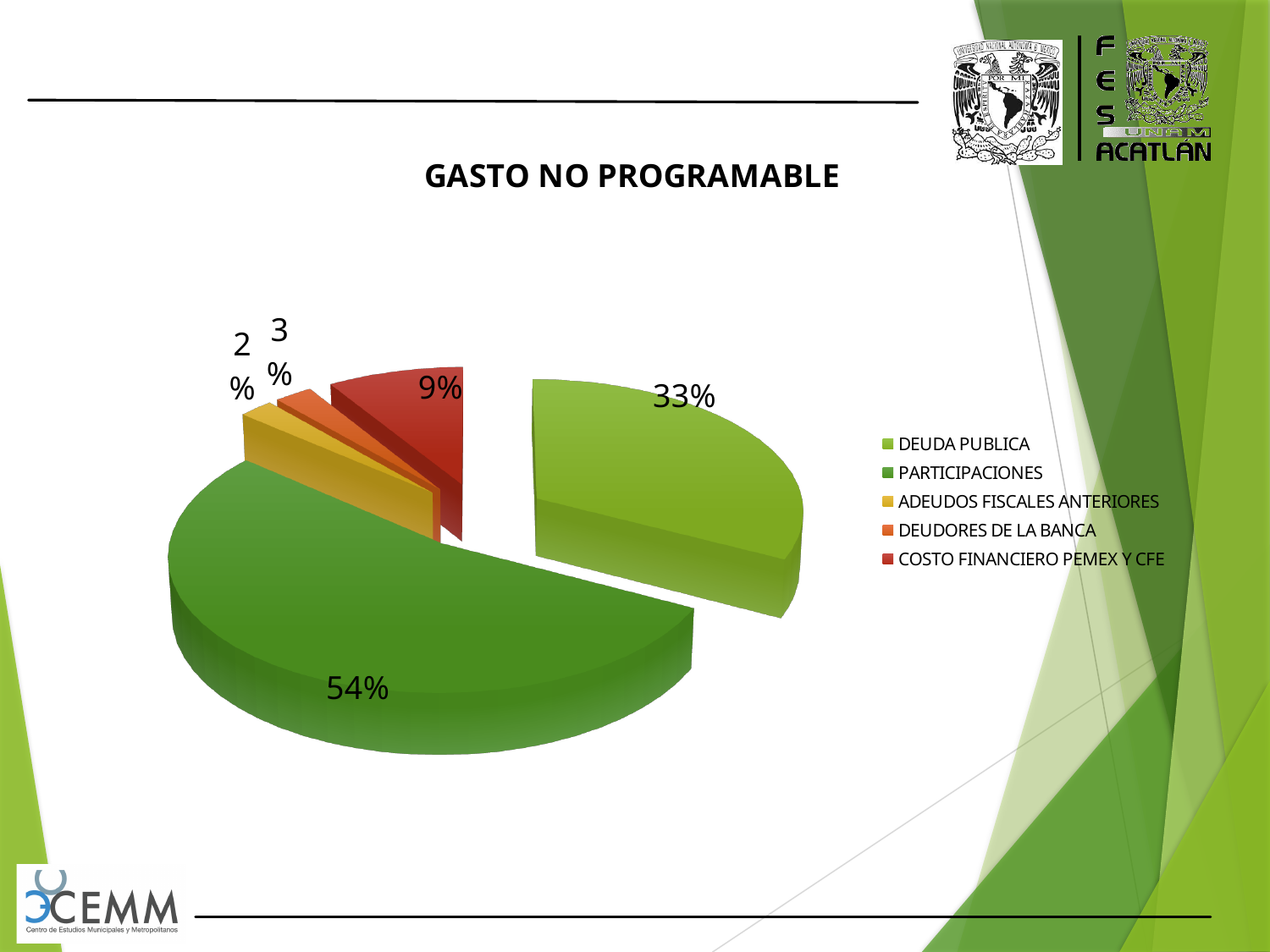
What percentage of the pie does ADEUDOS FISCALES ANTERIORES represent? 2% What percentage of the pie does DEUDA PUBLICA represent? 33% What is the difference in percentage points between PARTICIPACIONES and DEUDA PUBLICA? 21 Which category has the largest share of the pie? PARTICIPACIONES What is the title of the chart? GASTO NO PROGRAMABLE Which category has the smallest share of the pie? ADEUDOS FISCALES ANTERIORES Which is larger, the share for COSTO FINANCIERO PEMEX Y CFE or the share for DEUDORES DE LA BANCA? COSTO FINANCIERO PEMEX Y CFE How many categories does the legend list? 5 What percentage of the pie does DEUDORES DE LA BANCA represent? 3% What percentage of the pie does COSTO FINANCIERO PEMEX Y CFE represent? 9% What percentage of the pie does PARTICIPACIONES represent? 54% What type of chart is shown on the slide? Pie chart